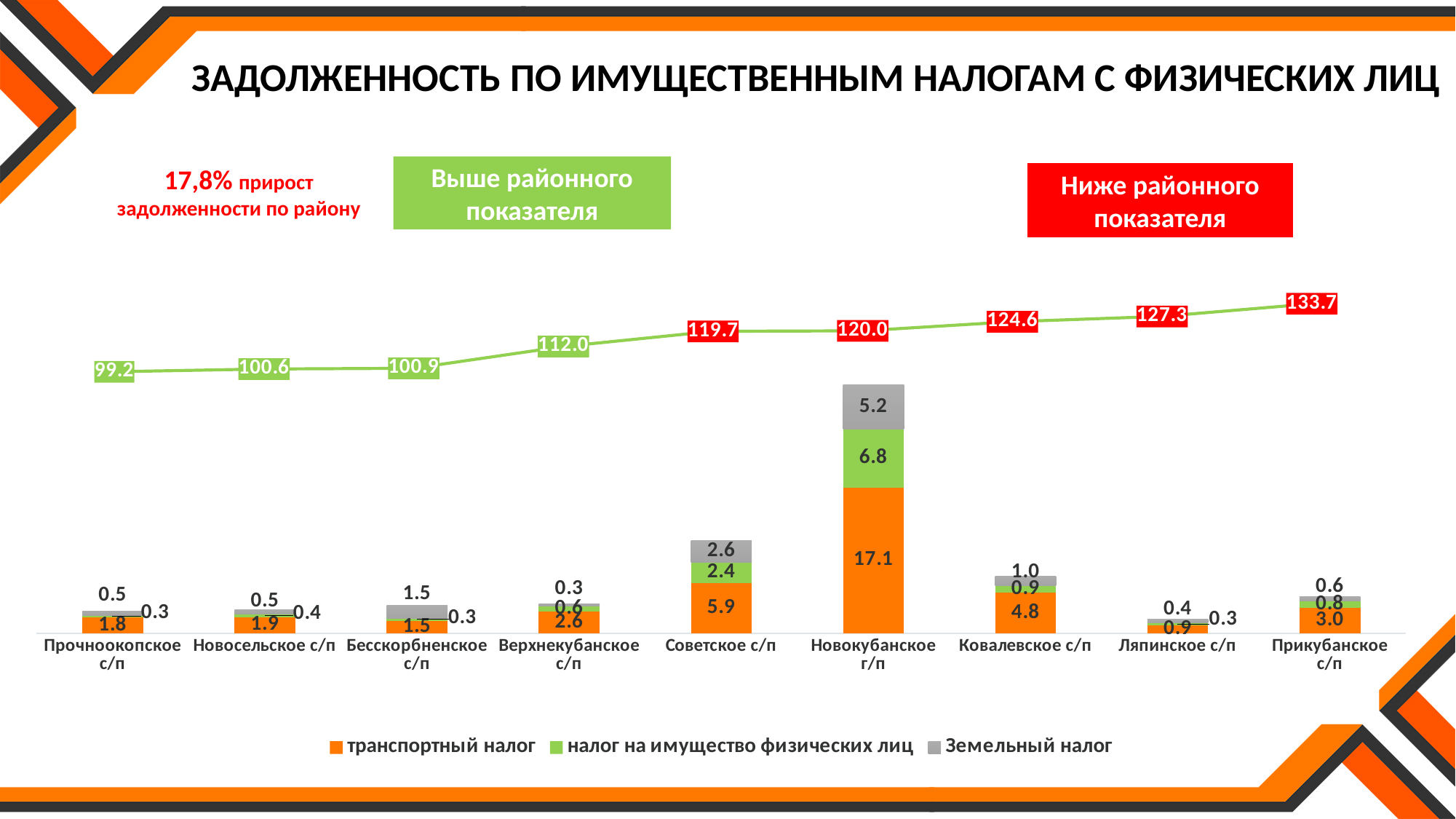
Which is larger: the налог на имущество физических лиц value for Советское с/п or for Ковалевское с/п? Советское с/п What is the total of the stacked bar for Новокубанское г/п? 29.1 How many categories are shown on the x axis? 9 What is the value of Земельный налог for Советское с/п? 2.6 Do the values of the line series rise or fall from left to right along the x axis? rise How many series does the legend list? 3 What is the value of транспортный налог for Новокубанское г/п? 17.1 Which category has the lowest value on the line series? Прочноокопское с/п What is the difference between the транспортный налог values for Новокубанское г/п and Советское с/п? 11.2 Which category has the highest транспортный налог value? Новокубанское г/п What is the value of the line series for Прикубанское с/п? 133.7 Which series is shown in orange in the legend? транспортный налог